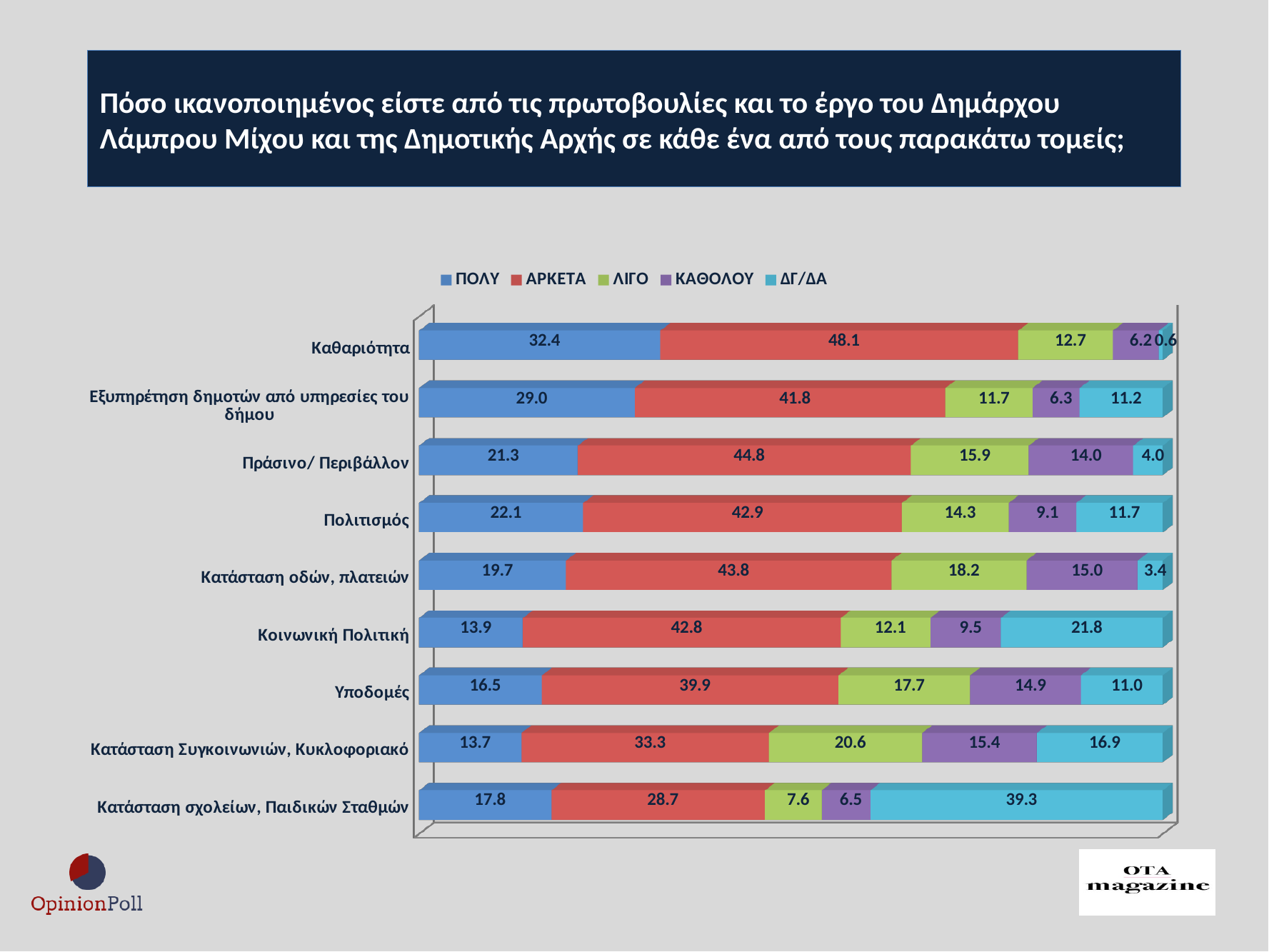
Which category has the highest ΠΟΛΥ value? Καθαριότητα What type of chart is shown on the slide? Stacked bar chart What is the ΚΑΘΟΛΟΥ value for Κατάσταση Συγκοινωνιών, Κυκλοφοριακό? 15.4 What is the ΠΟΛΥ value for Καθαριότητα? 32.4 How many categories (sectors) are shown in the chart? 9 Which is larger: the ΛΙΓΟ value for Κατάσταση Συγκοινωνιών, Κυκλοφοριακό or the ΛΙΓΟ value for Υποδομές? Κατάσταση Συγκοινωνιών, Κυκλοφοριακό What is the difference between the ΑΡΚΕΤΑ value for Καθαριότητα and the ΑΡΚΕΤΑ value for Κατάσταση σχολείων, Παιδικών Σταθμών? 19.4 Which category has the lowest ΔΓ/ΔΑ value? Καθαριότητα What is the ΔΓ/ΔΑ value for Κατάσταση σχολείων, Παιδικών Σταθμών? 39.3 Which legend entry is shown in red? ΑΡΚΕΤΑ Which category has the highest ΔΓ/ΔΑ value? Κατάσταση σχολείων, Παιδικών Σταθμών How many series does the legend list? 5